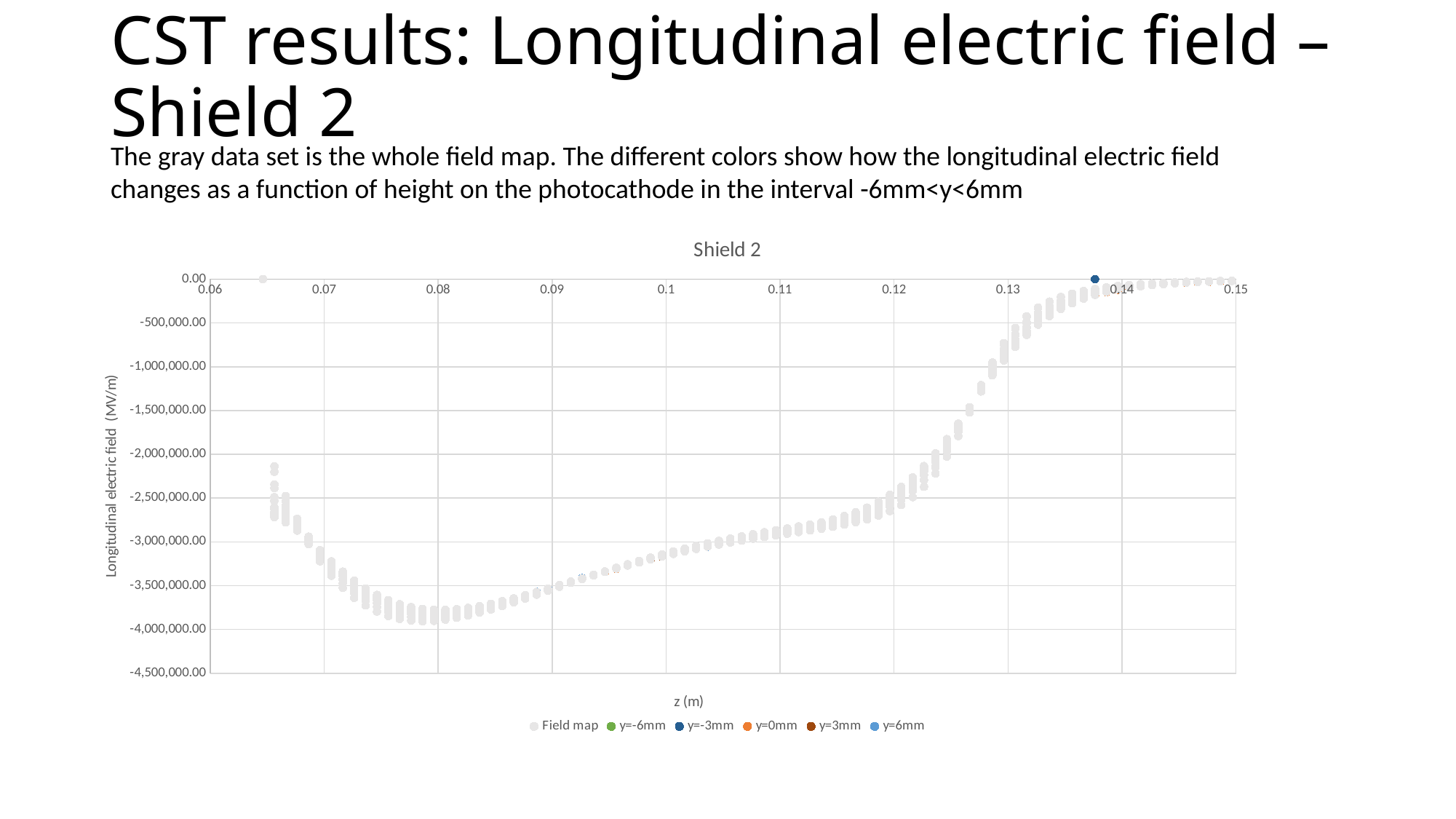
Is the Field map value at z = 0.14 greater or less than -500,000.00? greater Is the Field map value at z = 0.12 greater or less than -3,000,000.00? greater Is the Field map value at z = 0.07 greater or less than -2,500,000.00? less What is the label of the x axis? z (m) Which is larger, the Field map value at z = 0.1 or at z = 0.13? z = 0.13 What kind of chart is shown on the slide? Scatter chart How many series does the chart legend list? 6 Do the Field map values rise or fall as z increases from 0.08 to 0.15? rise What is the title of the chart? Shield 2 Around which x-axis value does the Field map series reach its lowest point? 0.08